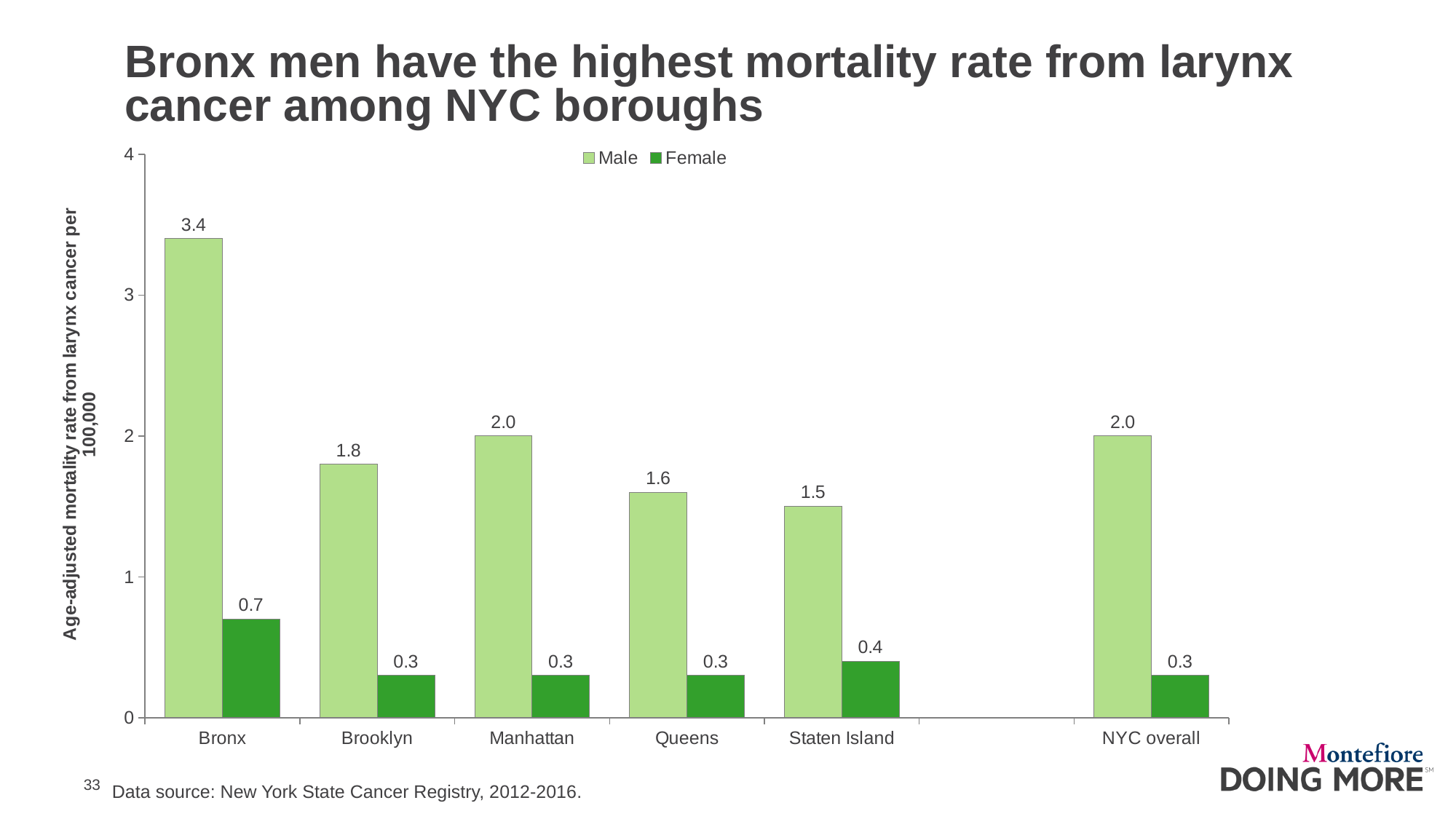
How much higher is the Bronx male mortality rate than the NYC overall male rate? 1.4 What is the difference between the male and female mortality rates in the Bronx? 2.7 What is the female mortality rate from larynx cancer in Staten Island? 0.4 Which borough has the highest male mortality rate from larynx cancer? Bronx How many series does the legend list? 2 Which is larger, the male mortality rate in Brooklyn or in Queens? Brooklyn Is the male mortality rate in the Bronx greater or less than 3? greater What is the male mortality rate from larynx cancer in the Bronx? 3.4 How many categories are shown on the x axis? 6 Which borough has the lowest male mortality rate from larynx cancer? Staten Island What is the male mortality rate for NYC overall? 2.0 What kind of chart is shown on the slide? Bar chart